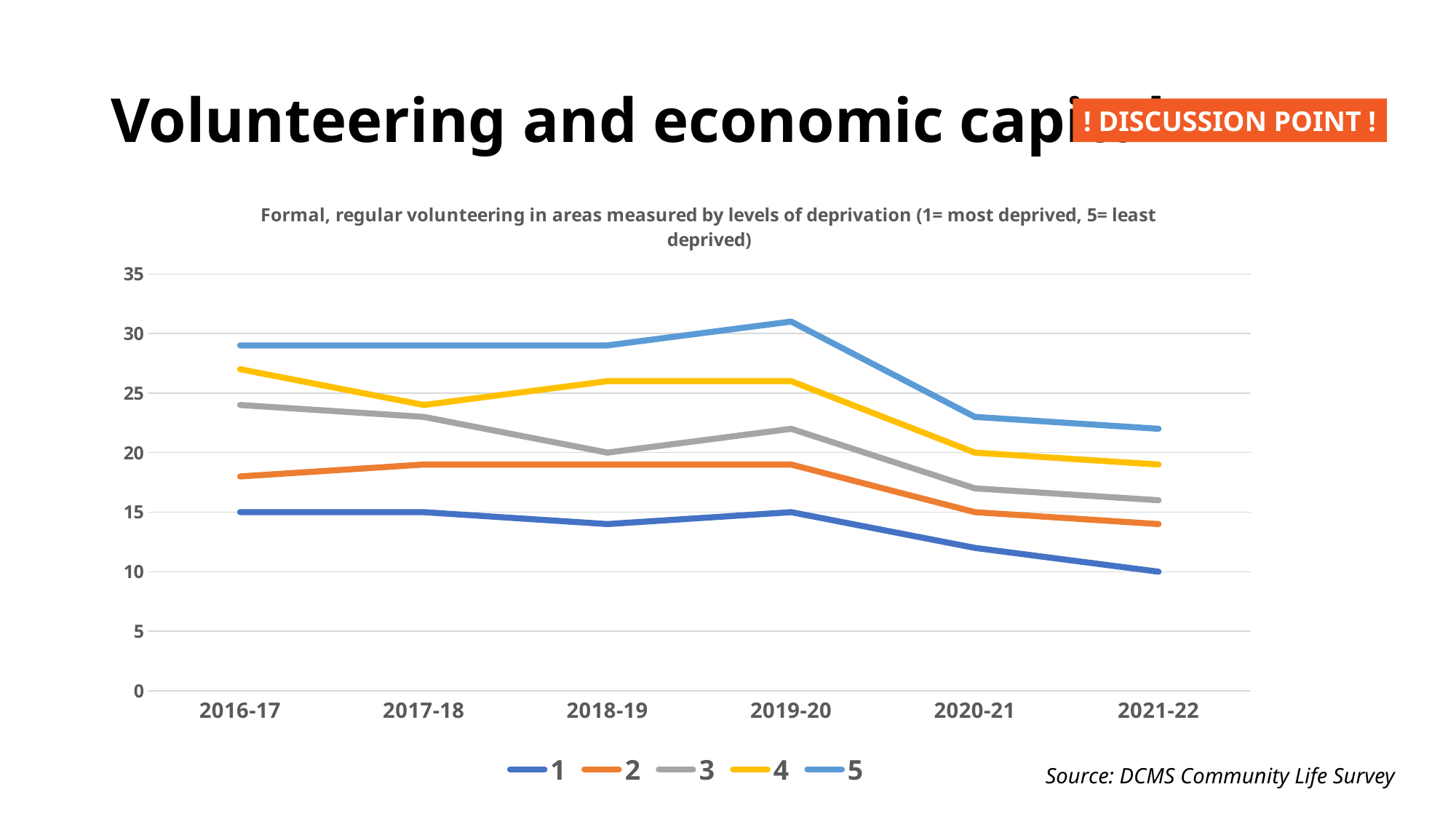
Which series has the lowest values across the whole chart? 1 What kind of chart is shown on the slide? Line chart Does series 1 rise or fall between 2019-20 and 2021-22? Fall Is the value for series 4 in 2016-17 greater or less than 25? greater How many series does the legend list? 5 What is the value for series 4 in 2020-21? 20 How many time periods are shown on the x axis? 6 What source is cited for the chart? DCMS Community Life Survey What is the value for series 1 in 2021-22? 10 Which series has the highest values across the whole chart? 5 Is the value for series 5 in 2021-22 greater or less than 25? less What is the value for series 1 in 2016-17? 15